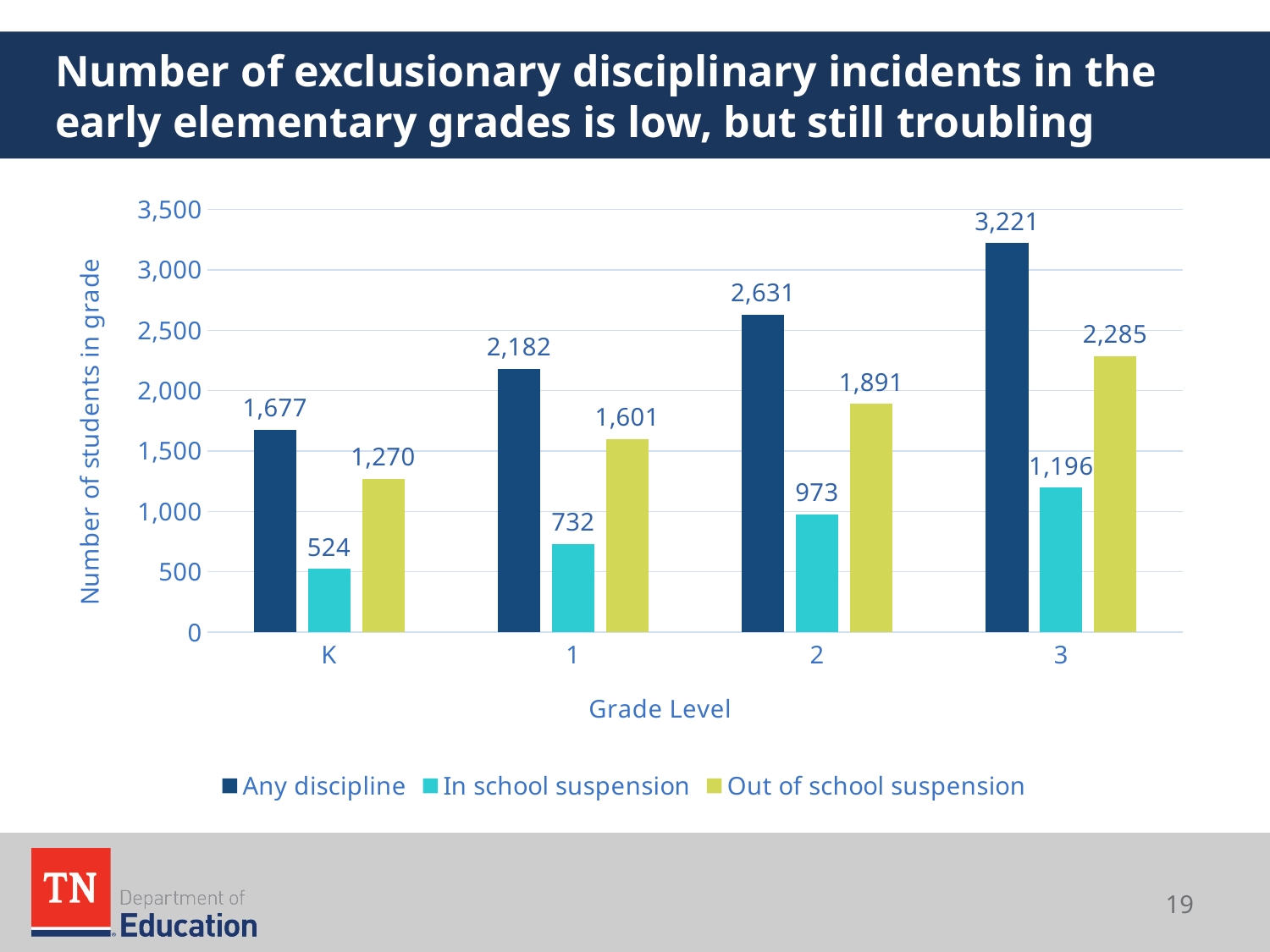
How many grade levels are shown on the x axis? 4 What is the label of the y axis? Number of students in grade What is the value for Out of school suspension in grade 1? 1,601 What kind of chart is shown on the slide? bar chart Do the values for Any discipline rise or fall from grade K to grade 3? rise What is the value for In school suspension in grade K? 524 Which grade level has the lowest value for In school suspension? K How many series does the legend list? 3 Which grade level has the highest value for Any discipline? 3 What is the difference between Any discipline in grade 3 and Any discipline in grade K? 1,544 What is the value for Any discipline in grade 2? 2,631 Which is larger: Out of school suspension in grade 2 or In school suspension in grade 3? Out of school suspension in grade 2